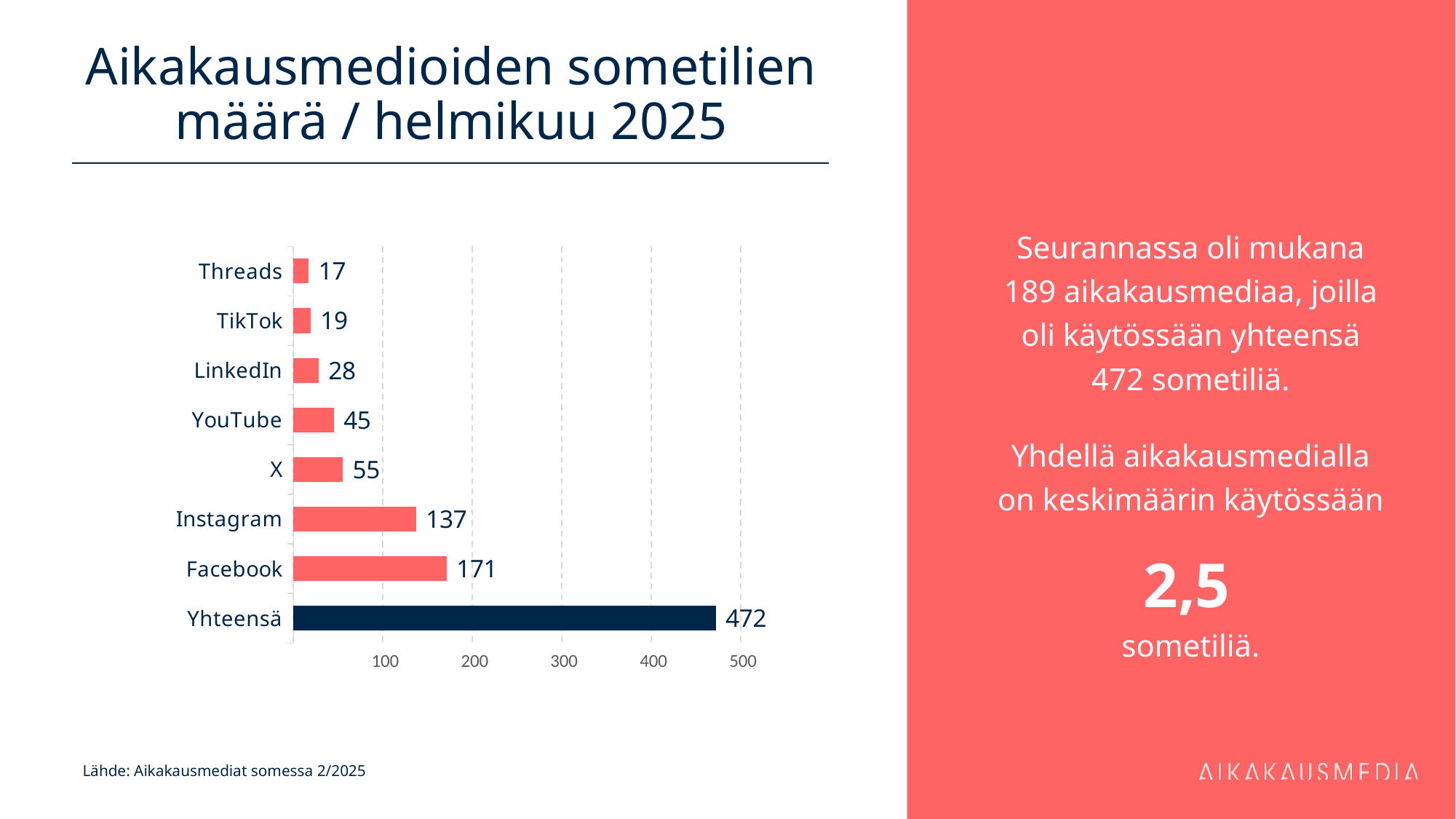
What is the value shown for Yhteensä? 472 Excluding the Yhteensä total bar, which platform has the highest value? Facebook What is the difference between the values for Facebook and Instagram? 34 What is the value for Facebook? 171 How many bars are shown in the chart, including the Yhteensä total bar? 8 What is the title of the slide? Aikakausmedioiden sometilien määrä / helmikuu 2025 Is the value for Instagram greater or less than 100? greater What is the value for LinkedIn? 28 What is the value for Instagram? 137 Which platform has the lowest value? Threads What kind of chart is shown on the slide? Bar chart Which has a larger value, YouTube or X? X